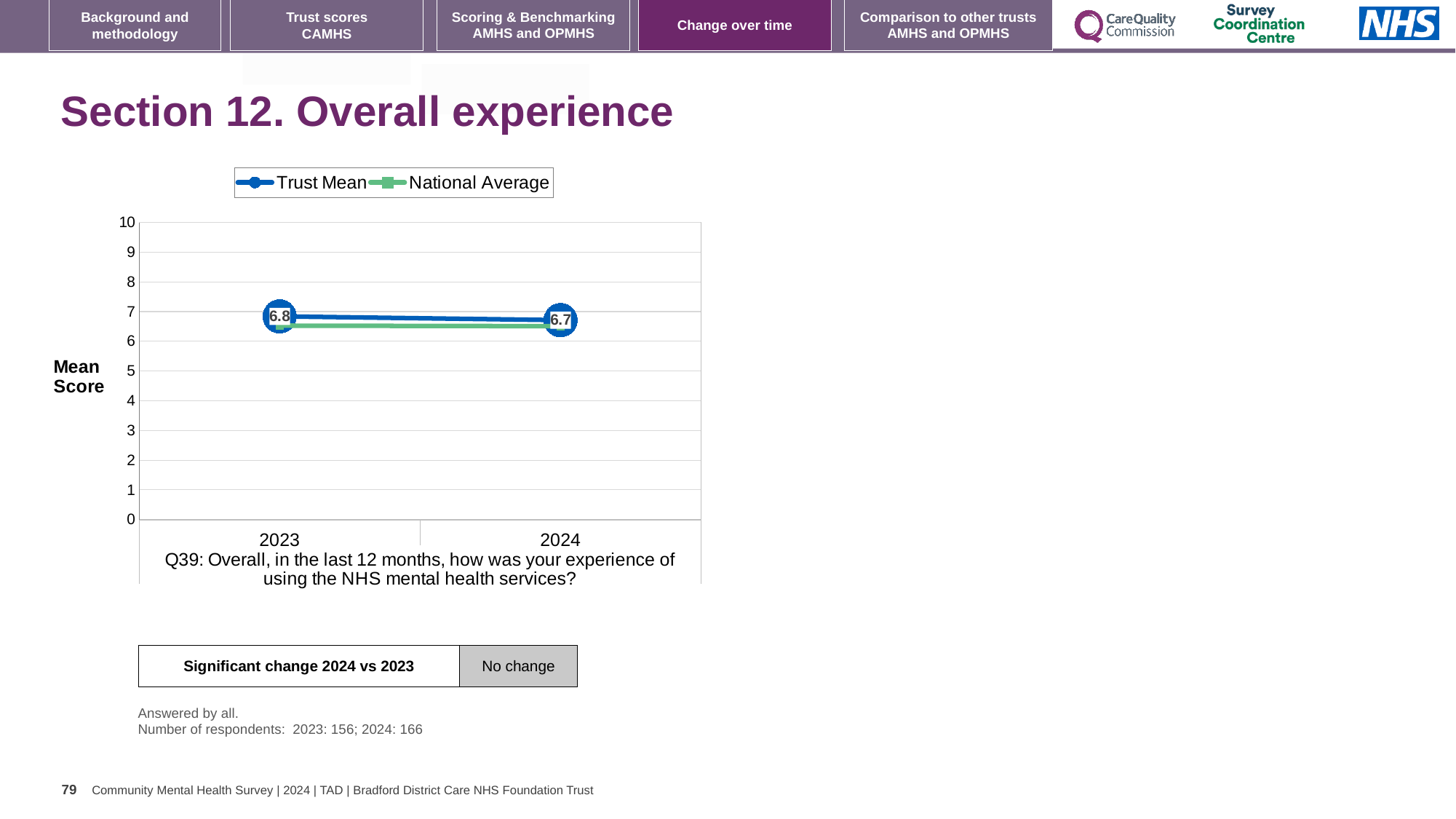
What is the label on the y axis of the chart? Mean Score Is the National Average value for 2024 greater or less than 5? greater How many years are plotted on the x axis? 2 Is the National Average value for 2023 greater or less than 7? less What is the Trust Mean value for 2023? 6.8 Does the Trust Mean rise or fall from 2023 to 2024? fall In 2023, which is larger: the Trust Mean or the National Average? Trust Mean What kind of chart is shown on the slide? line chart How many series does the legend list? 2 What is the difference between the Trust Mean in 2023 and in 2024? 0.1 In which year is the Trust Mean higher? 2023 What is the Trust Mean value for 2024? 6.7